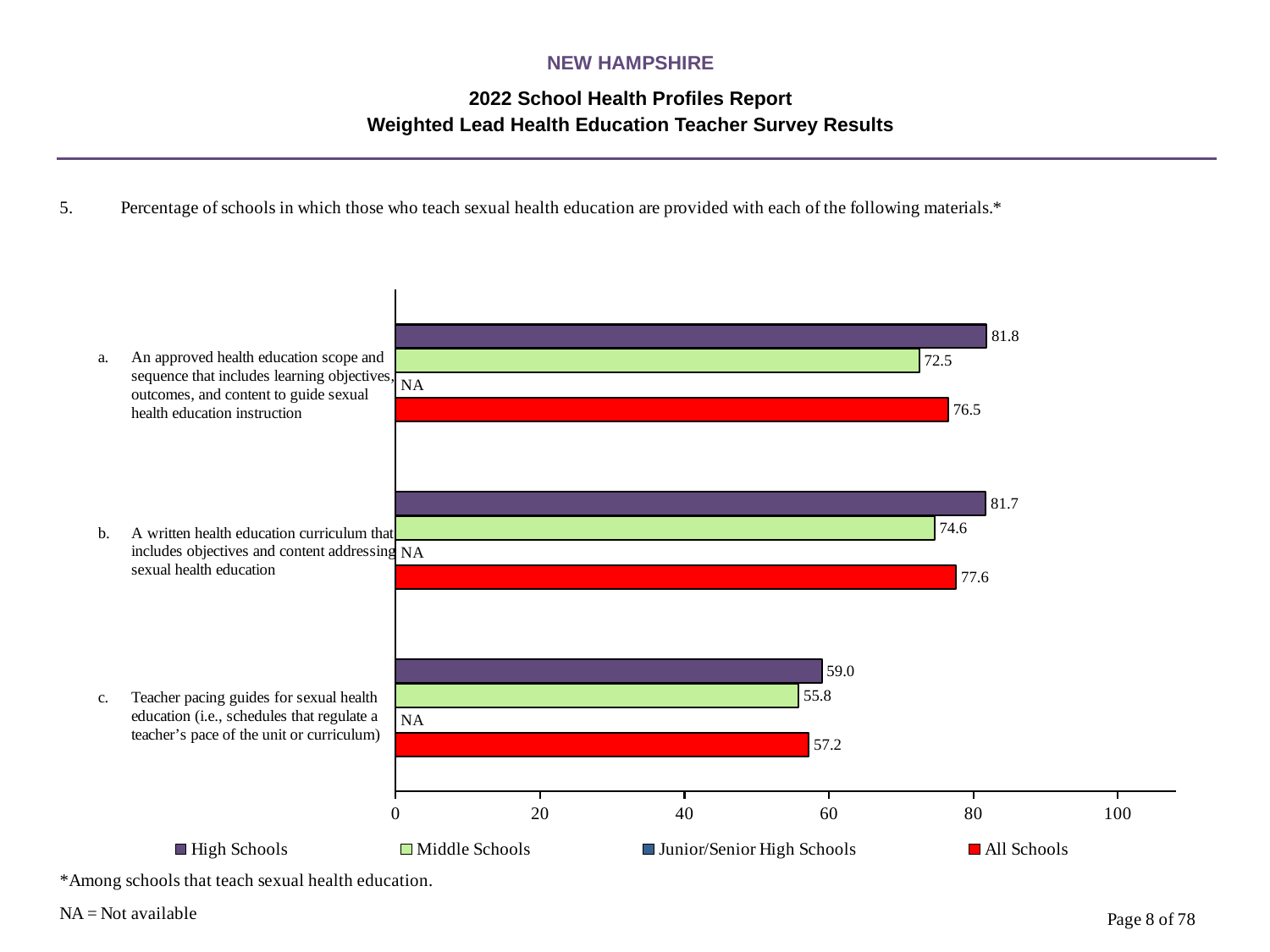
What is the All Schools value for item c, teacher pacing guides for sexual health education? 57.2 How many items (categories) are shown on the chart? 3 Which item has the highest All Schools value? b. A written health education curriculum that includes objectives and content addressing sexual health education What is the Middle Schools value for item b, a written health education curriculum? 74.6 How many series does the legend list? 4 What is the difference between the High Schools and Middle Schools values for item a? 9.3 What is shown for Junior/Senior High Schools for item a? NA What kind of chart is this? Bar chart For item c, which is larger: the High Schools value or the Middle Schools value? High Schools Which item has the lowest High Schools value? c. Teacher pacing guides for sexual health education What colour represents All Schools in the legend? Red What is the High Schools value for item a, an approved health education scope and sequence? 81.8